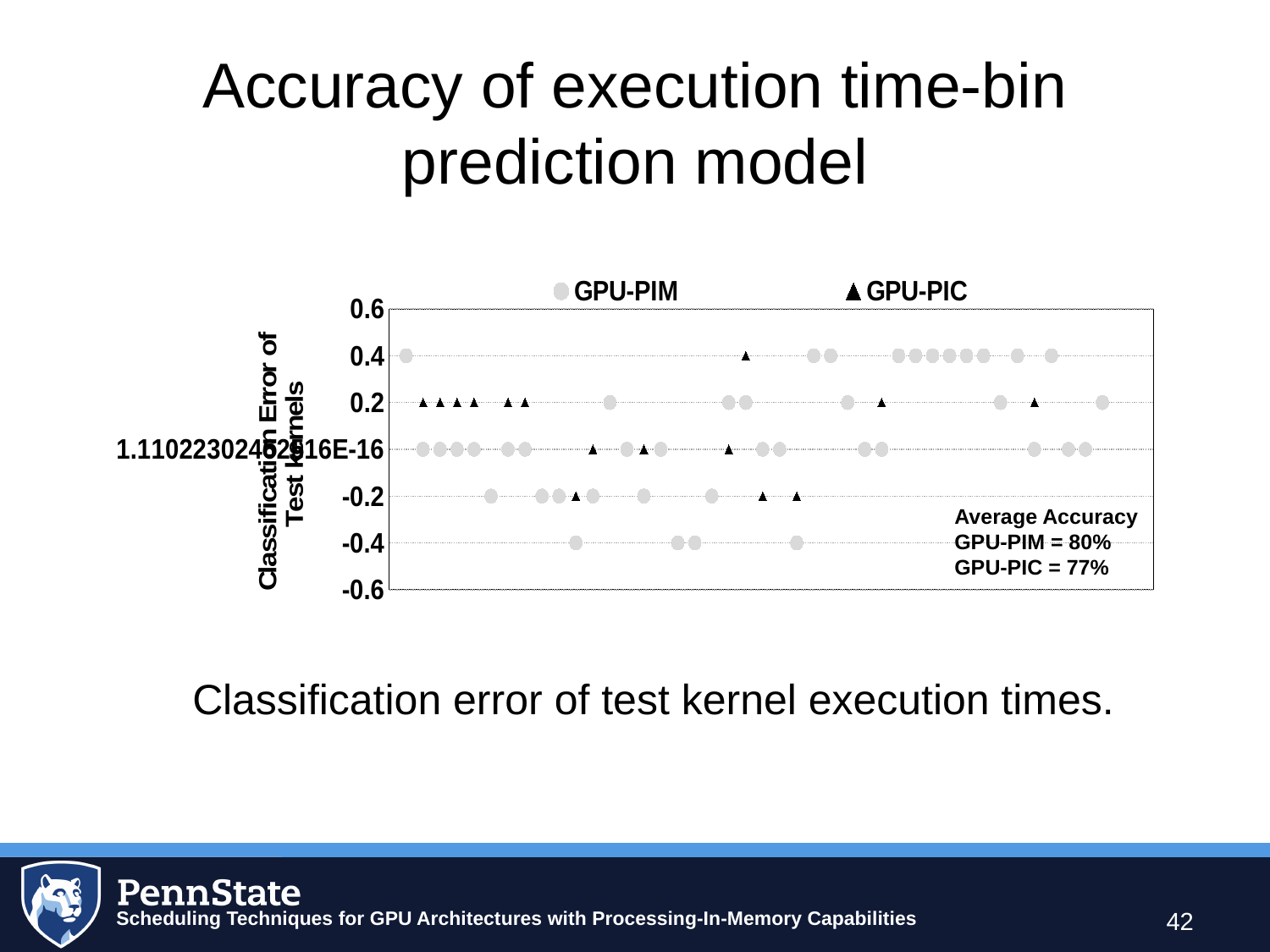
What is the highest tick value shown on the vertical axis of the chart? 0.6 What kind of chart is shown on the slide? scatter chart Which has the higher average accuracy, GPU-PIM or GPU-PIC? GPU-PIM What is the highest classification error value plotted for the GPU-PIM series? 0.4 What are the two series named in the chart legend? GPU-PIM and GPU-PIC What is the difference between the average accuracy of GPU-PIM and GPU-PIC? 3% What is the lowest classification error value plotted for the GPU-PIM series? -0.4 What is the average accuracy reported for GPU-PIM on the chart? 80% What is the title of the chart's vertical axis? Classification Error of Test Kernels How many series does the chart legend list? 2 What is the average accuracy reported for GPU-PIC on the chart? 77%